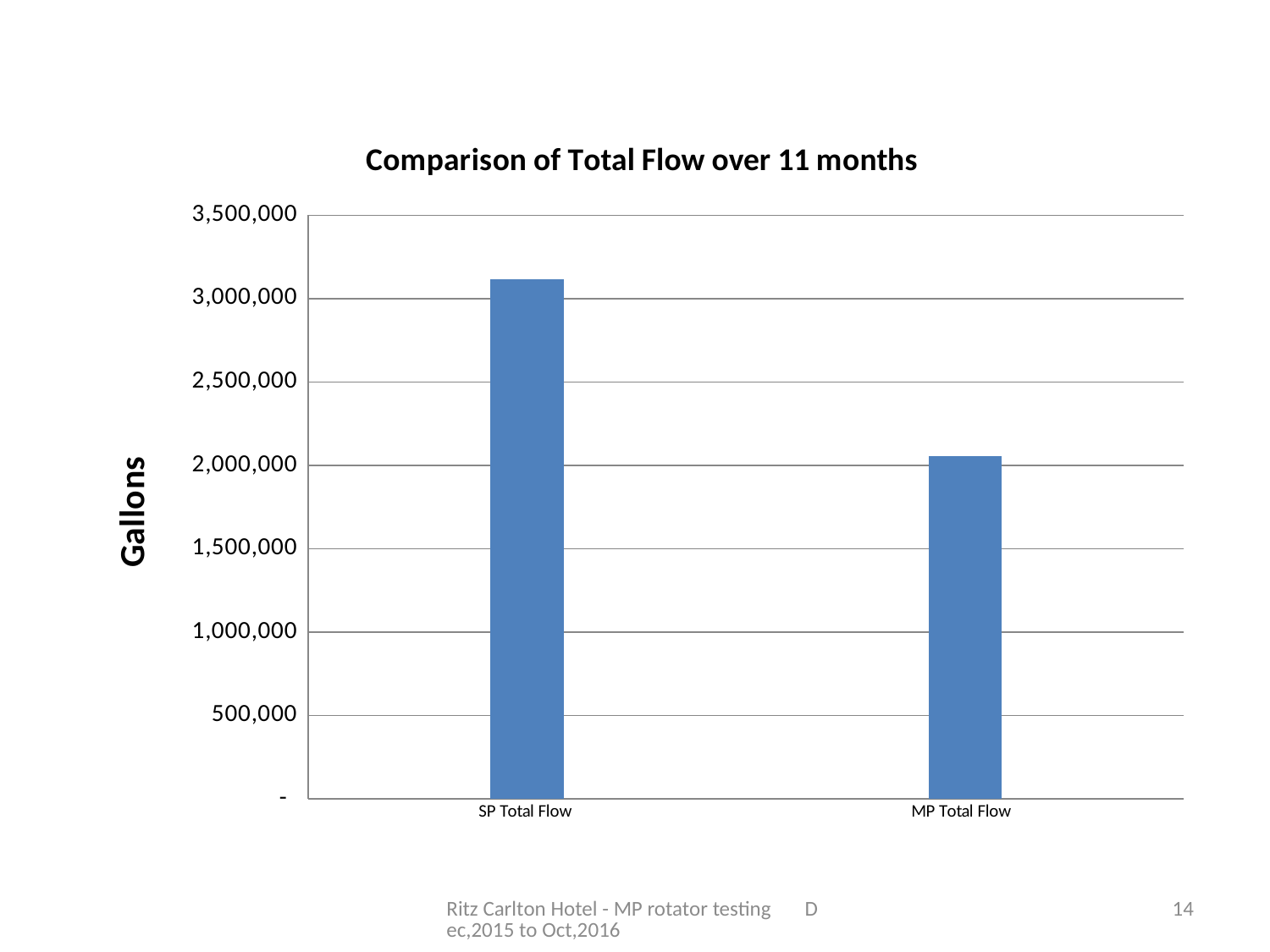
How many categories are plotted in the chart? 2 Is the value for SP Total Flow greater or less than 3,500,000? less Is the value for SP Total Flow greater or less than 3,000,000? greater What is the title of the chart? Comparison of Total Flow over 11 months Is the value for MP Total Flow greater or less than 2,000,000? greater What is the label of the vertical axis? Gallons Which category has the lowest total flow? MP Total Flow Which is larger, SP Total Flow or MP Total Flow? SP Total Flow What type of chart is shown on the slide? bar chart Which category has the highest total flow? SP Total Flow